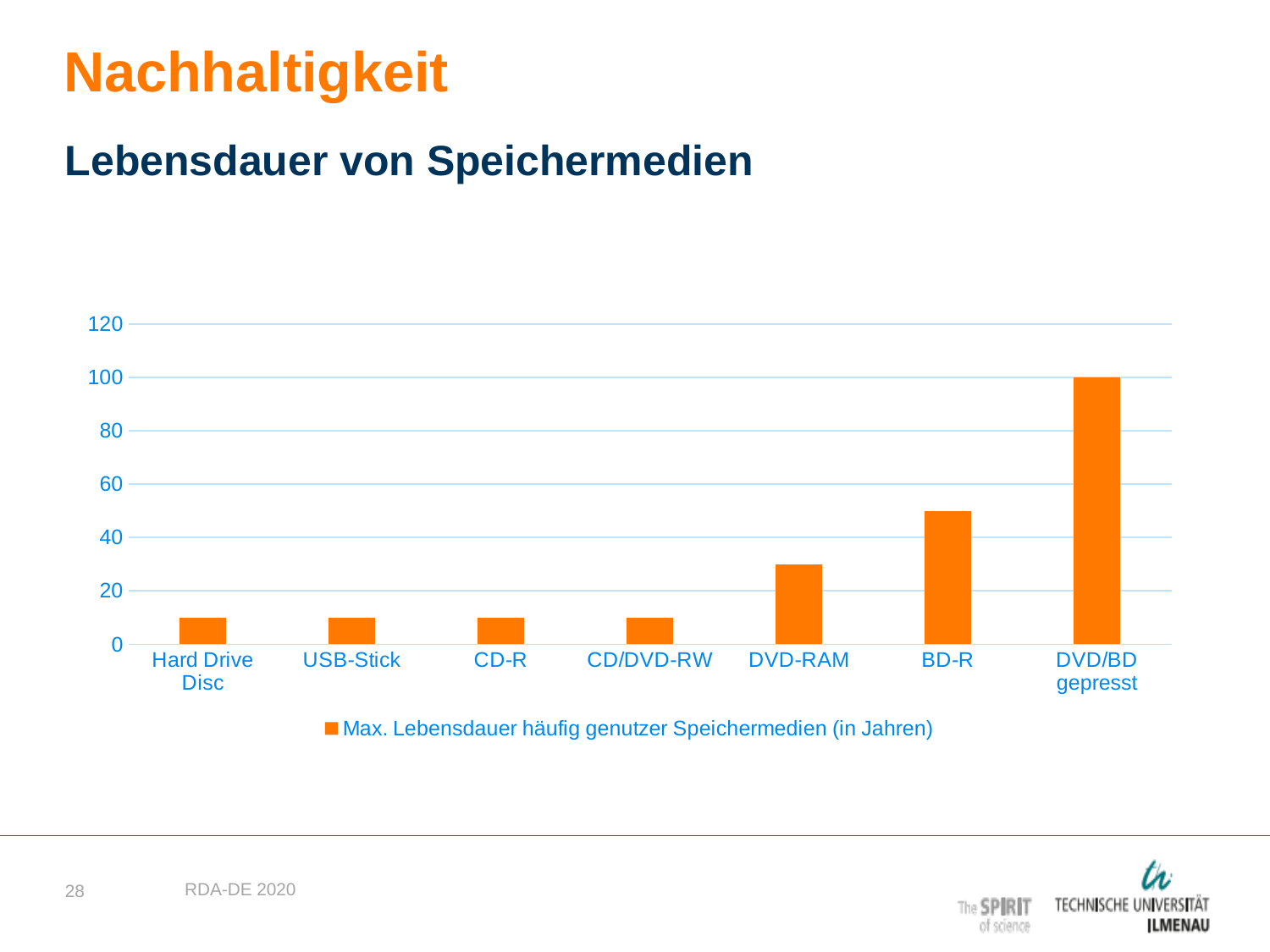
Is the value for DVD-RAM greater or less than 40? less What kind of chart is shown on the slide? bar chart Is the value for BD-R greater or less than 60? less Which has the larger value, DVD/BD gepresst or CD-R? DVD/BD gepresst How many storage media categories are shown on the x axis of the chart? 7 How many series does the chart legend list? 1 Is the value for USB-Stick greater or less than 20? less Which has the larger value, BD-R or DVD-RAM? BD-R What is the legend entry of the series shown in the chart? Max. Lebensdauer häufig genutzer Speichermedien (in Jahren) Which storage medium has the highest maximum lifespan in the chart? DVD/BD gepresst What is the value for DVD/BD gepresst in the chart? 100